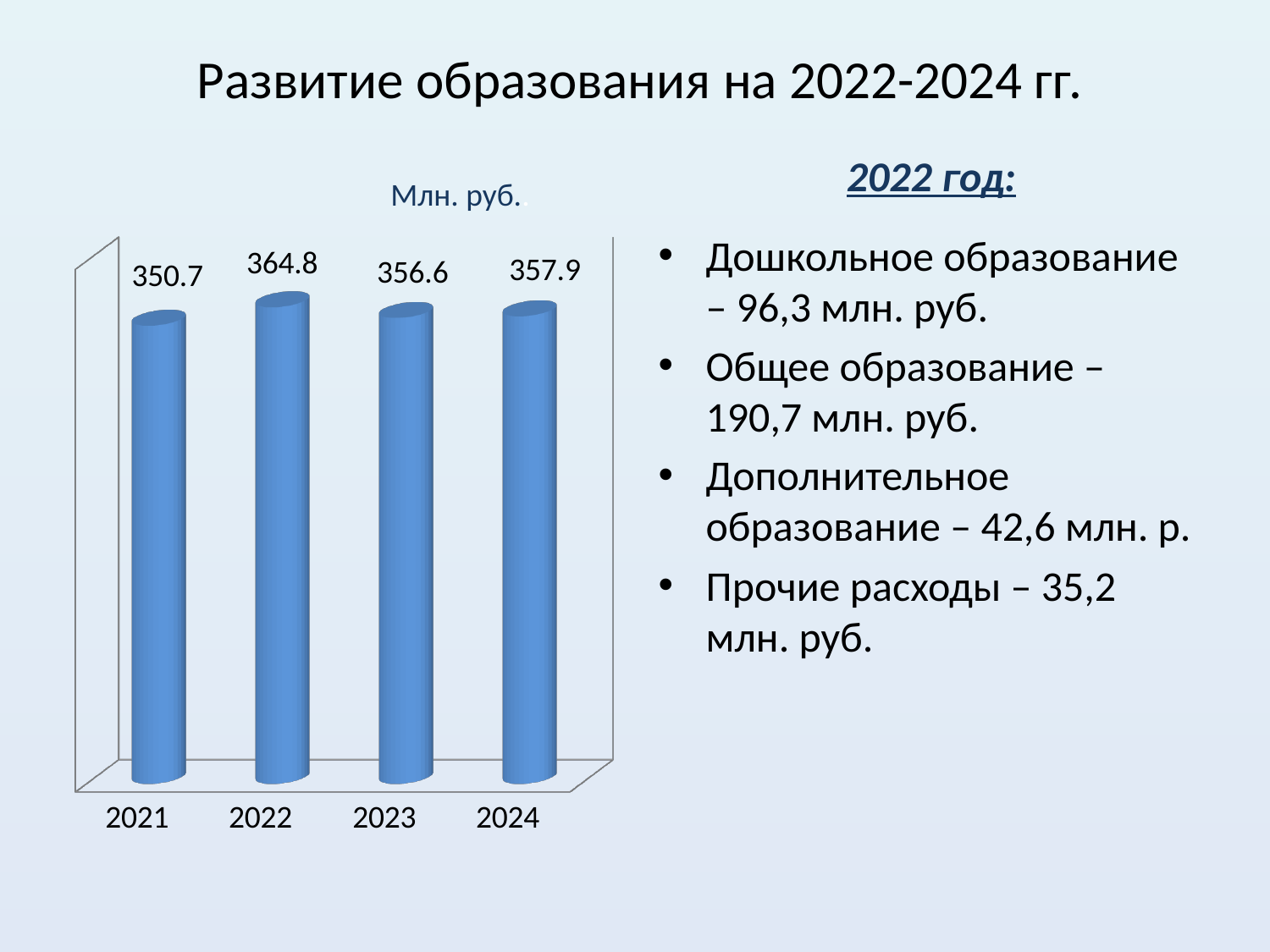
Which year has the lowest value? 2021 What is the value for 2021? 350.7 What is the value for 2024? 357.9 Which year has the highest value? 2022 What kind of chart is shown on the slide? bar chart What is the difference between the values for 2024 and 2023? 1.3 Which is larger, the value for 2022 or the value for 2023? 2022 How many years are shown on the chart? 4 What is the title of the chart? Млн. руб. What is the value for 2022? 364.8 What is the difference between the values for 2022 and 2021? 14.1 What is the value for 2023? 356.6